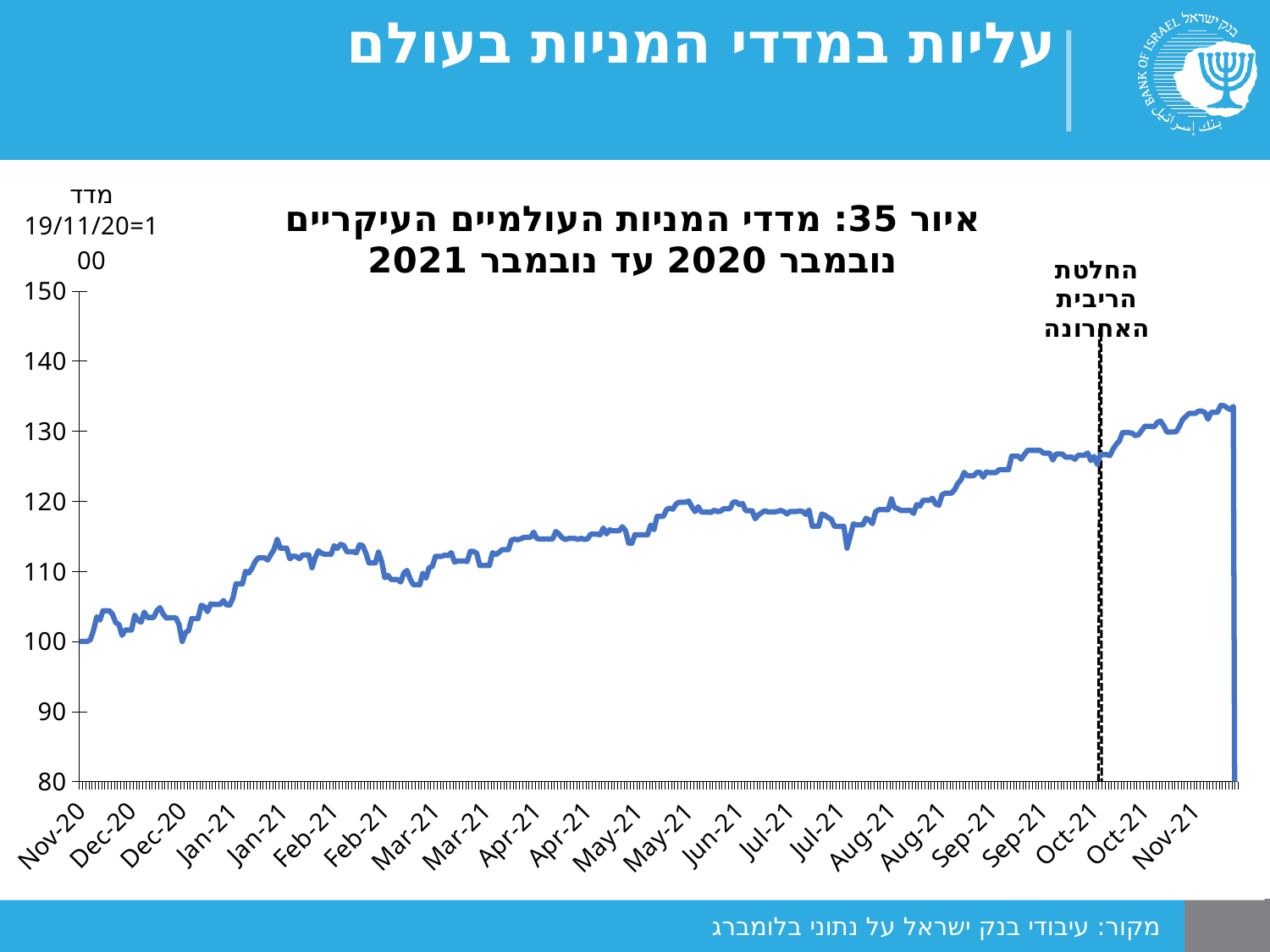
Is the value of the index around Jul-21 greater or less than 130? less What kind of chart is shown on the slide? line chart Which is larger, the index value at Nov-21 or at Nov-20? Nov-21 What is the highest value shown on the vertical axis? 150 How many lines (series) are plotted on the chart? 1 Is the value of the index at the start of the series (Nov-20) greater or less than 110? less What is the title of the chart? איור 35: מדדי המניות העולמיים העיקריים נובמבר 2020 עד נובמבר 2021 Is the value of the index at the end of the series (Nov-21) greater or less than 130? greater Overall, does the index rise or fall from Nov-20 to Nov-21? rise What base date and value is the index normalised to, according to the axis label? 19/11/20=100